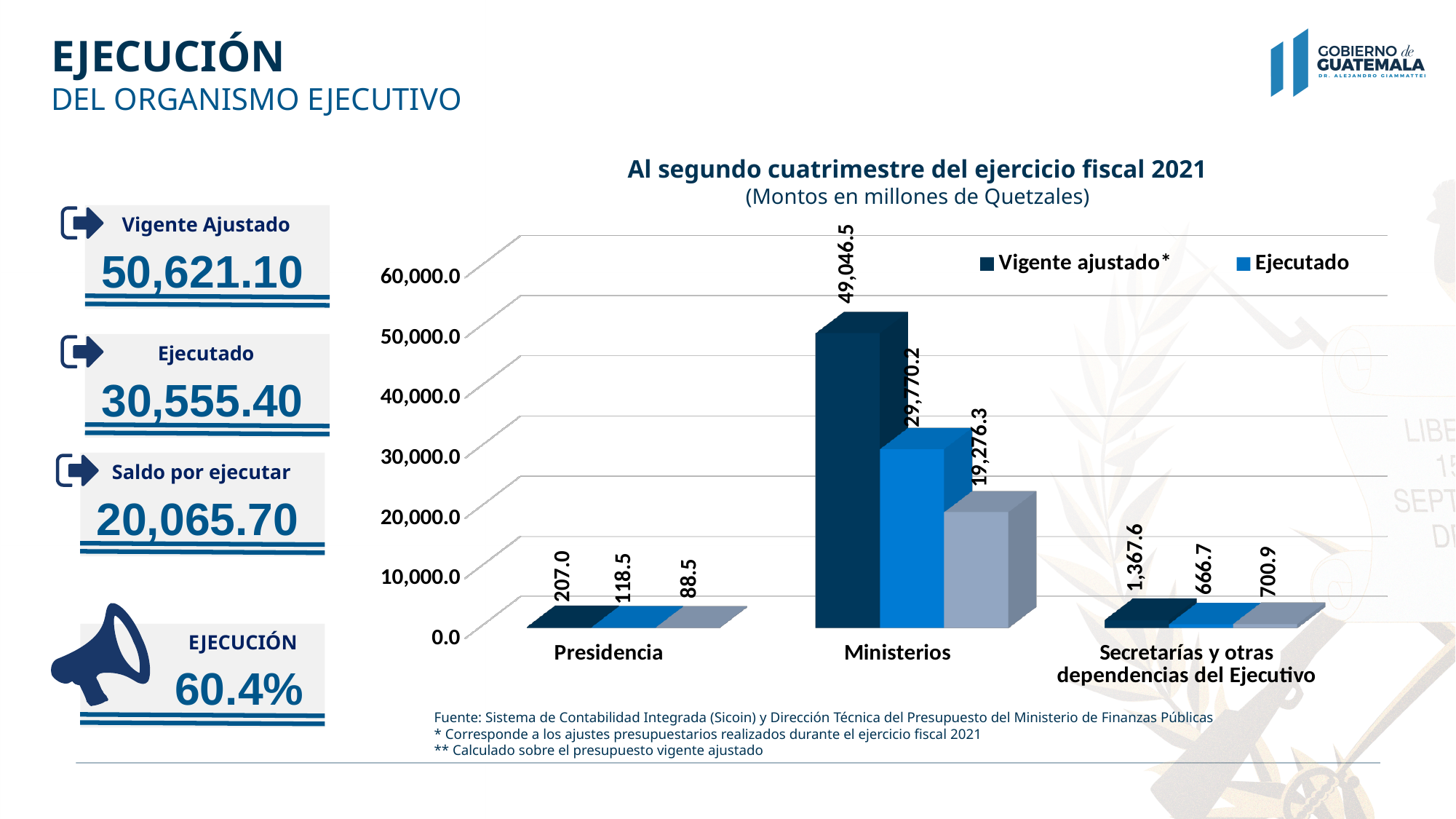
How many series does the chart legend list? 2 What is the difference between the Vigente ajustado and Ejecutado values for Ministerios? 19,276.3 What kind of chart is shown on the slide? bar chart What is the Vigente ajustado value for Secretarías y otras dependencias del Ejecutivo? 1,367.6 Which category has the lowest Ejecutado value? Presidencia What is the Ejecutado value for Presidencia? 118.5 What is the Ejecutado value for Secretarías y otras dependencias del Ejecutivo? 666.7 Which category has the highest Vigente ajustado value? Ministerios Which has a larger Vigente ajustado value, Presidencia or Secretarías y otras dependencias del Ejecutivo? Secretarías y otras dependencias del Ejecutivo What is the Vigente ajustado value for Ministerios? 49,046.5 Is the Ejecutado value for Ministerios greater or less than 20,000.0? greater How many categories are shown on the x axis of the chart? 3